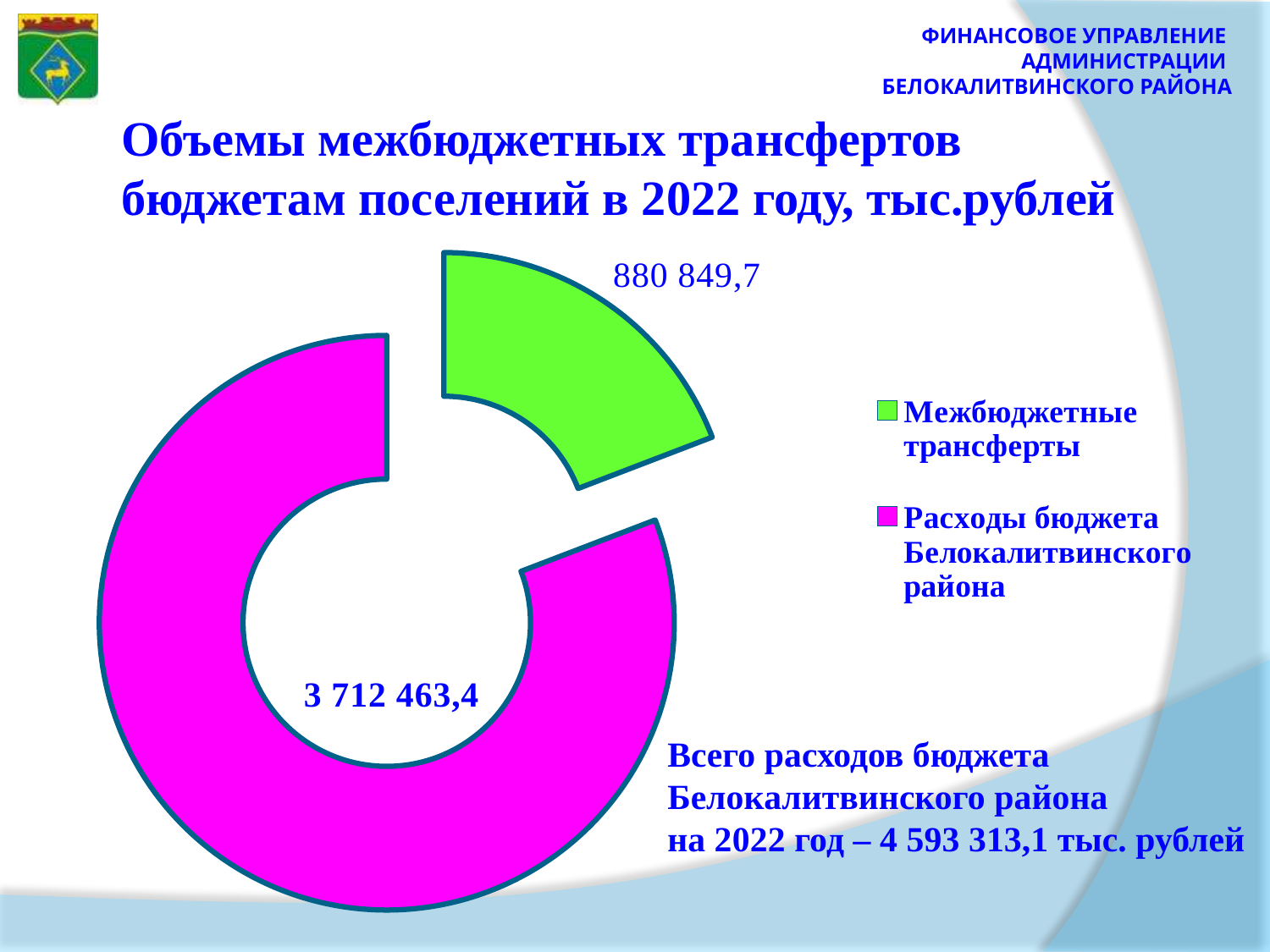
What is the difference between Расходы бюджета Белокалитвинского района and Межбюджетные трансферты? 2 831 613,7 What kind of chart is shown on the slide? doughnut chart Which is larger: Межбюджетные трансферты or Расходы бюджета Белокалитвинского района? Расходы бюджета Белокалитвинского района What is the total of the two slices, as stated on the slide? 4 593 313,1 тыс. рублей What is the value for Межбюджетные трансферты? 880 849,7 Which category has the largest slice? Расходы бюджета Белокалитвинского района What is the title of the chart? Объемы межбюджетных трансфертов бюджетам поселений в 2022 году, тыс.рублей How many slices does the chart have? 2 What is the value for Расходы бюджета Белокалитвинского района? 3 712 463,4 Which category has the smallest slice? Межбюджетные трансферты What colour is the slice for Межбюджетные трансферты? green How many entries does the legend list? 2